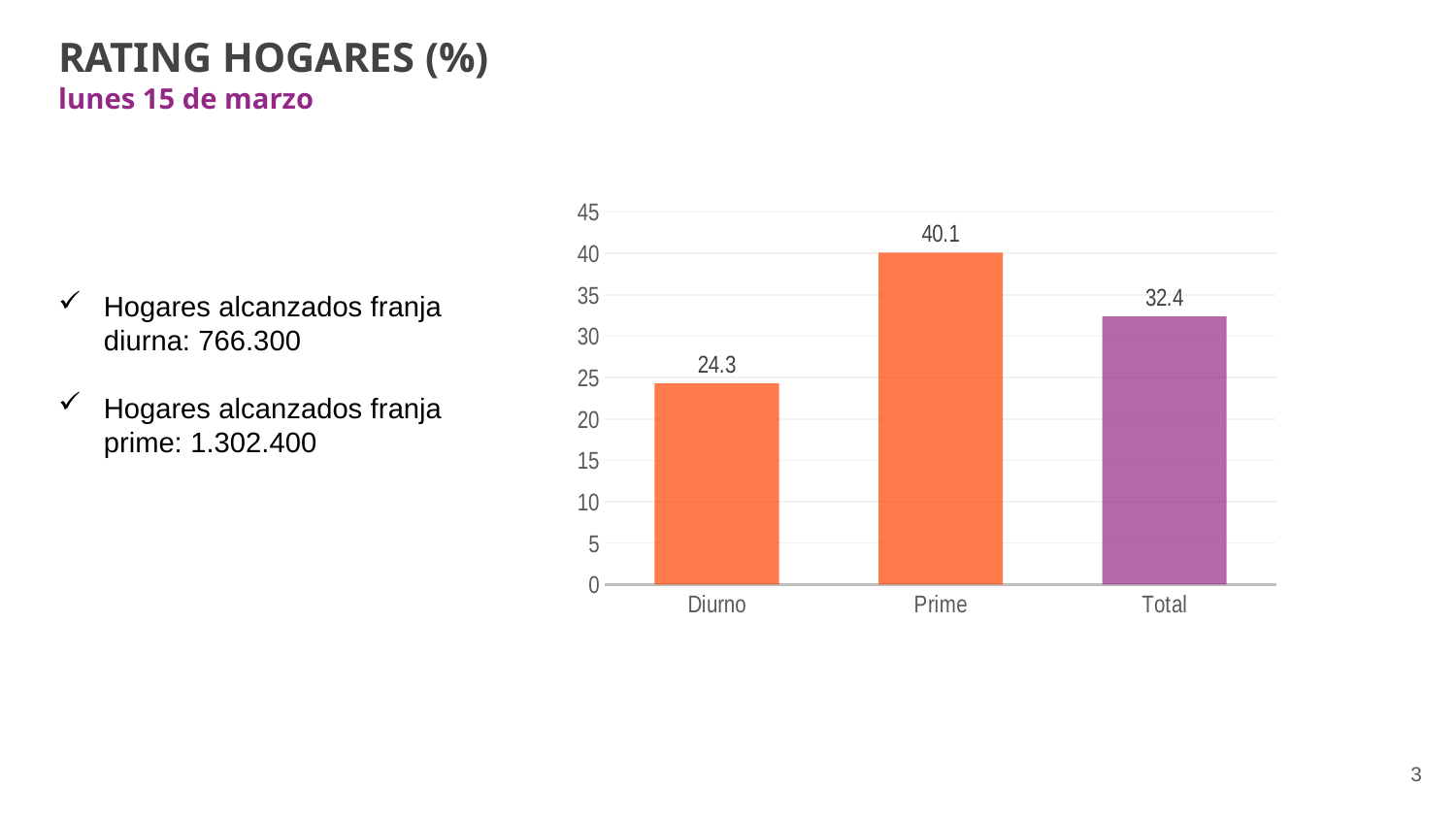
Which category has the highest value? Prime What is the difference between the values for Prime and Diurno? 15.8 What is the value for Prime? 40.1 What is the value for Diurno? 24.3 Which is larger, the value for Diurno or the value for Total? Total What kind of chart is shown on the slide? bar chart Which category has the lowest value? Diurno How many categories are shown on the x axis? 3 Is the value for Prime greater or less than 35? greater What is the value for Total? 32.4 What is the difference between the values for Prime and Total? 7.7 Which bar is coloured purple rather than orange? Total